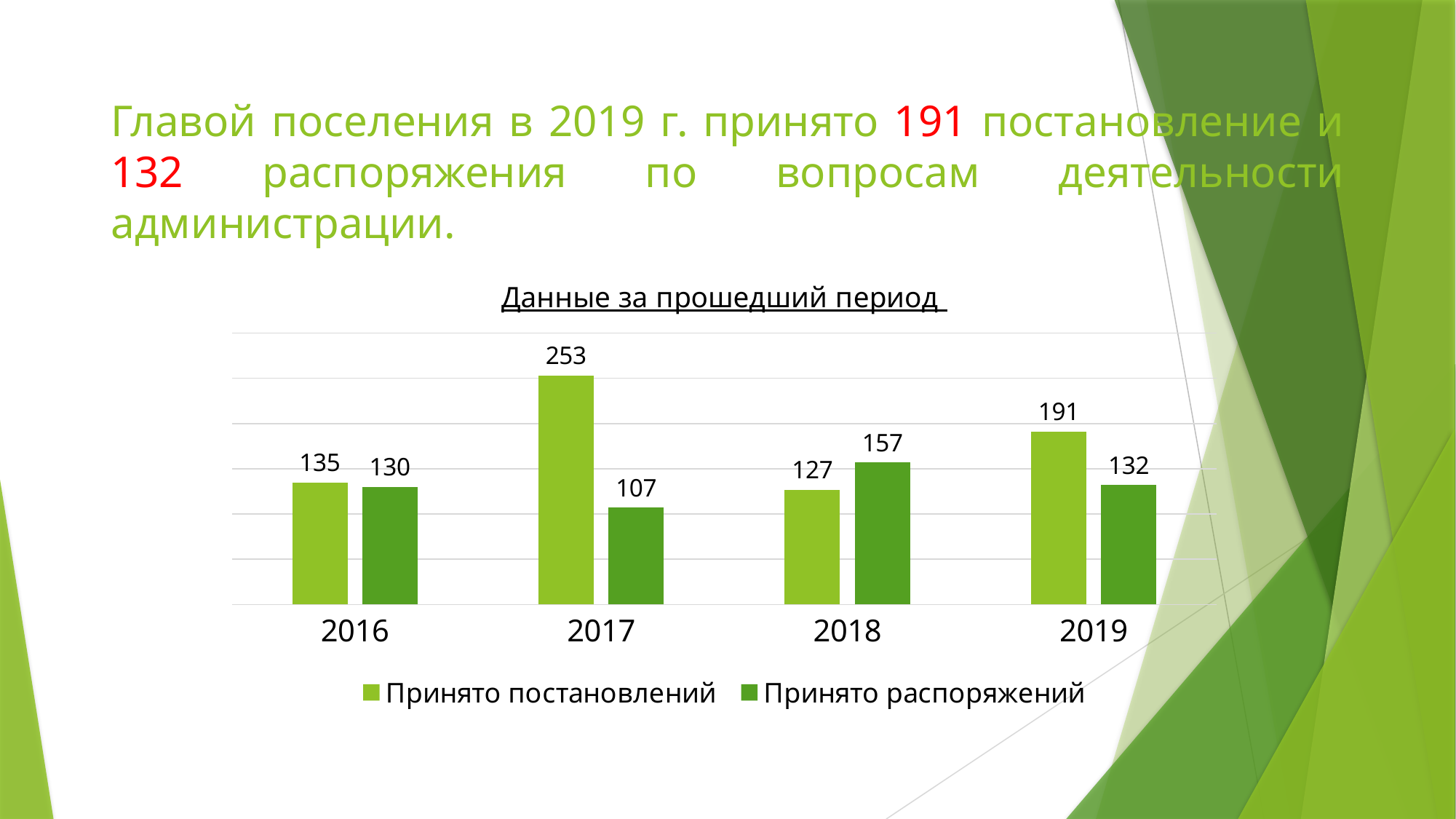
What is the value for "Принято постановлений" in 2017? 253 What is the title of the chart? Данные за прошедший период Which is larger in 2018: "Принято постановлений" or "Принято распоряжений"? Принято распоряжений How many years are shown on the x axis? 4 What kind of chart is shown on the slide? Bar chart What is the difference between "Принято распоряжений" in 2018 and in 2019? 25 What is the value for "Принято постановлений" in 2019? 191 How many series does the legend list? 2 In which year is the value for "Принято постановлений" highest? 2017 In which year is the value for "Принято распоряжений" lowest? 2017 What is the value for "Принято распоряжений" in 2018? 157 What is the difference between "Принято постановлений" and "Принято распоряжений" in 2017? 146